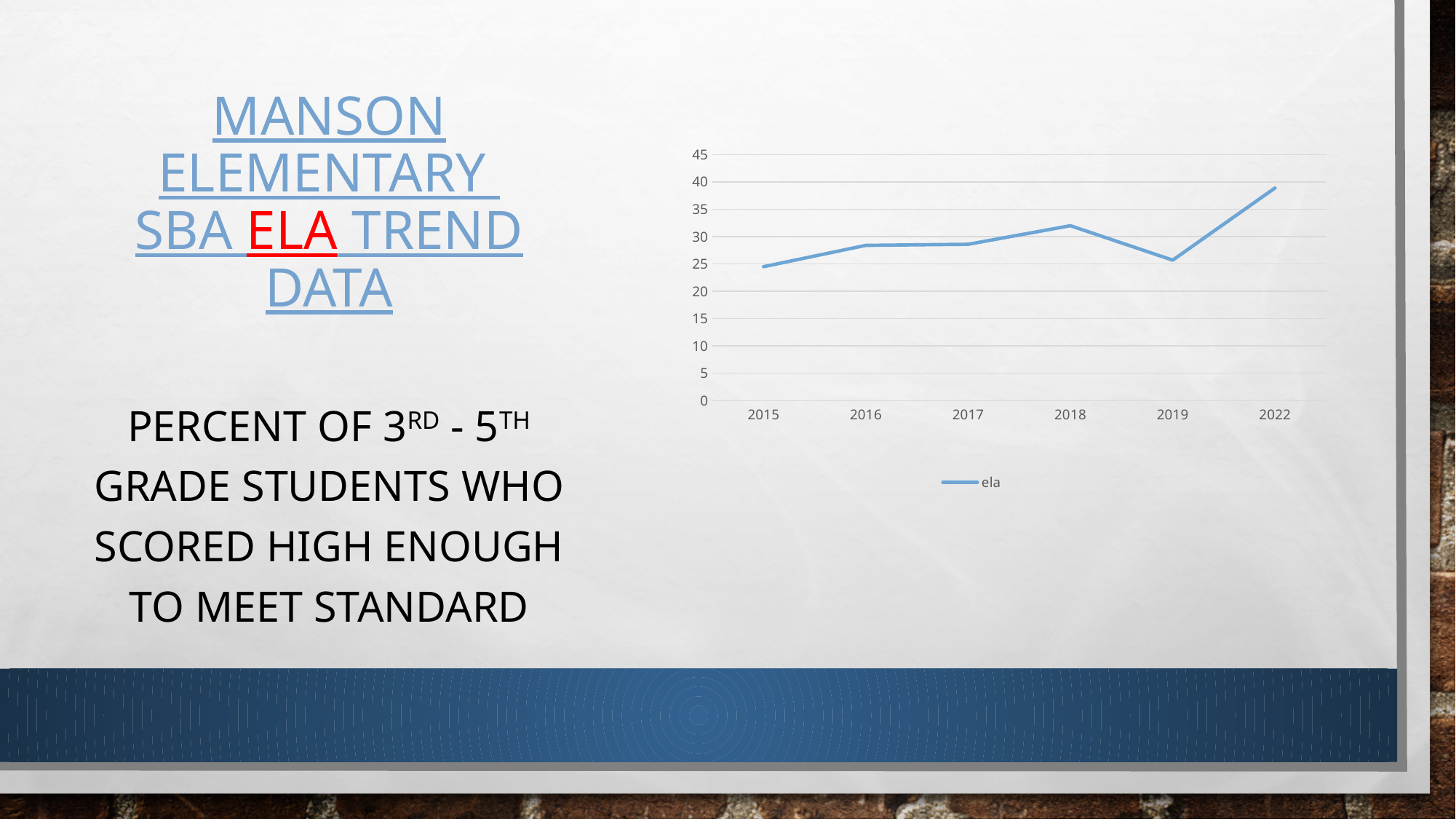
Is the value for 2018 greater or less than 30? greater How many years are plotted along the x axis? 6 How many series does the legend list? 1 Is the value for 2019 greater or less than 30? less What kind of chart is shown on the slide? line chart Does the value rise or fall from 2018 to 2019? fall Is the value for 2022 greater or less than 35? greater What is the name of the series shown in the legend? ela Does the value rise or fall from 2019 to 2022? rise Which is larger, the value for 2018 or the value for 2019? 2018 Which year has the highest value? 2022